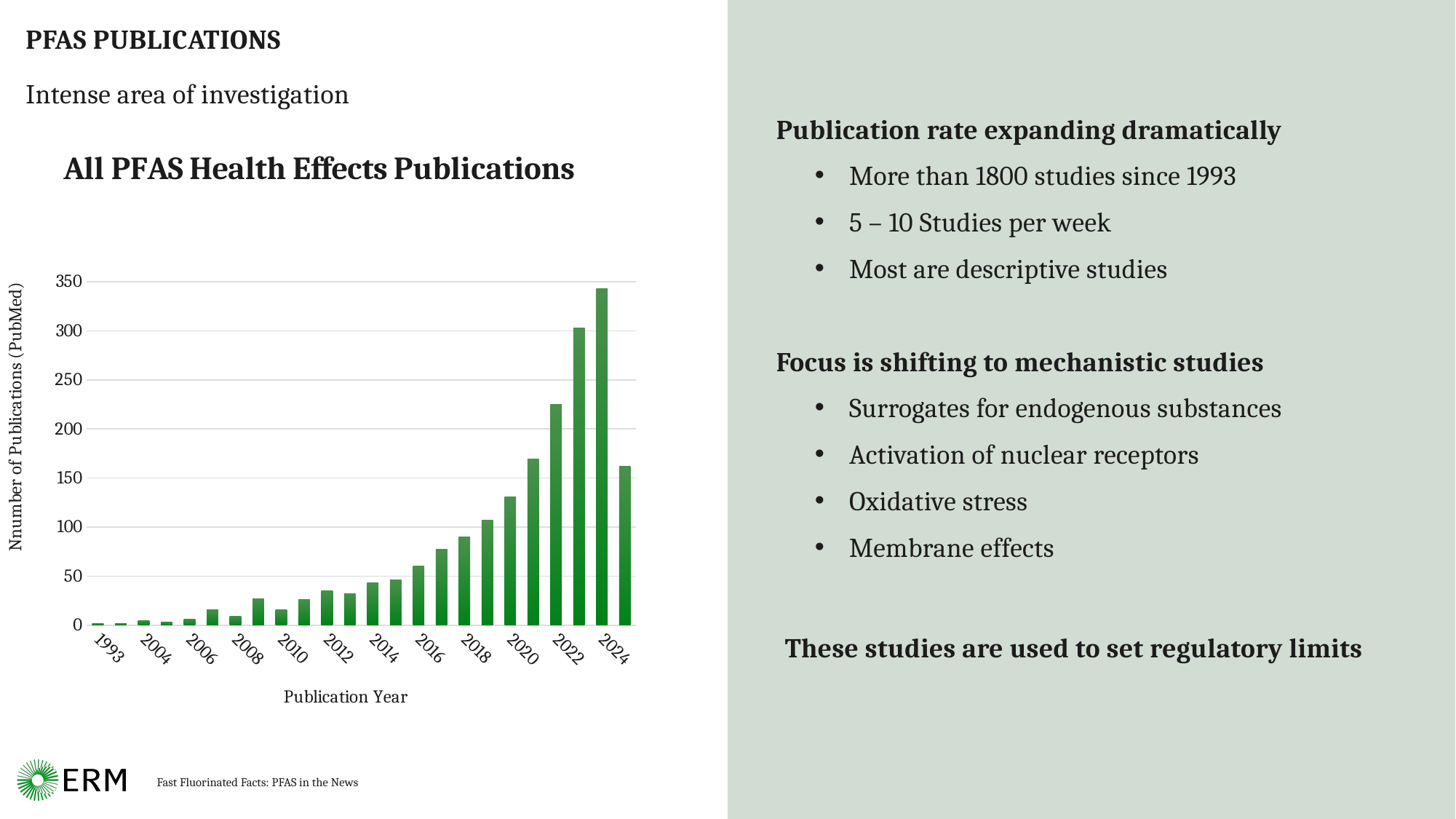
Which year has a higher number of publications, 2022 or 2024? 2024 Is the value for 2012 greater or less than 50? less Is the value for 2018 greater or less than 100? less Is the value for 2020 greater or less than 150? less Which labelled year has the lowest number of publications? 1993 What is the label of the x axis of the chart? Publication Year What kind of chart is shown on the slide? bar chart What is the title of the chart? All PFAS Health Effects Publications Do the number of publications generally rise or fall from 1993 to 2022? rise